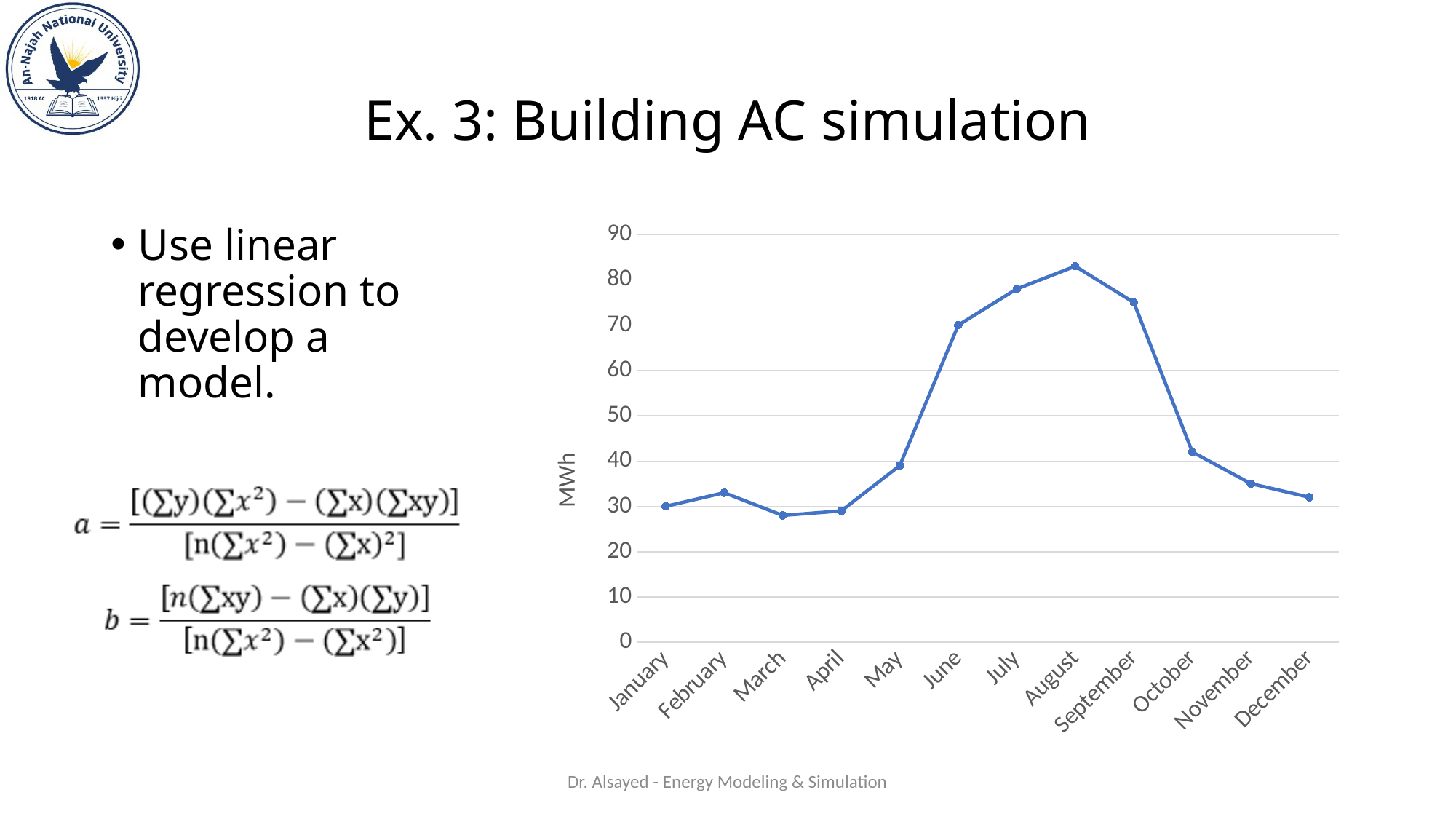
Do the values rise or fall from August to December? fall How many months are plotted on the x axis of the chart? 12 Is the value for July greater or less than 80? less What is the label on the y axis of the chart? MWh Which month has the highest value in the chart? August Is the value for August greater or less than 80? greater What is the value for June in the chart? 70 What kind of chart is shown on the slide? line chart Which month has the larger value, July or October? July Is the value for September greater or less than 70? greater What is the value for January in the chart? 30